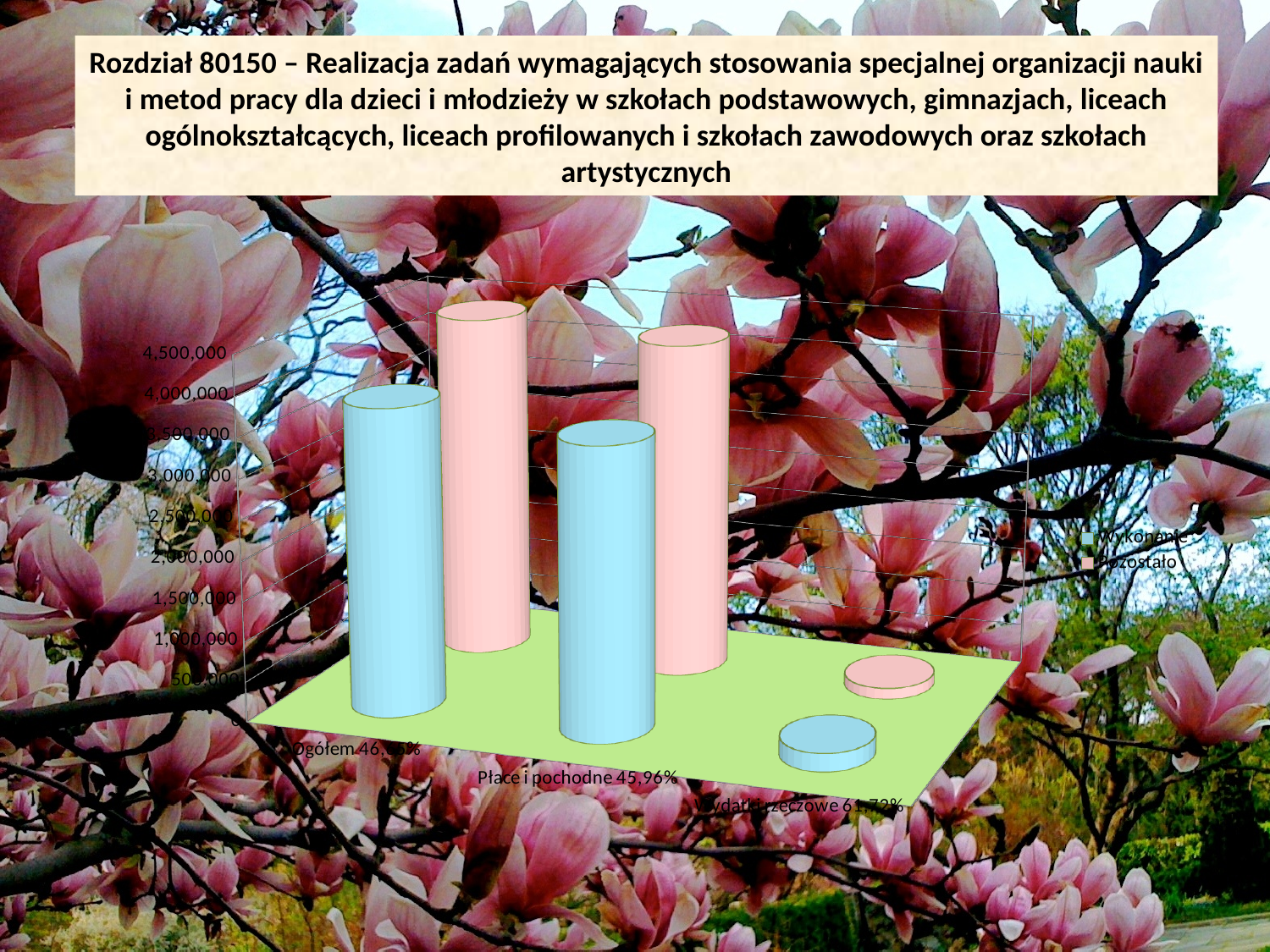
Which is larger, the Wykonanie value for Płace i pochodne or the Wykonanie value for Wydatki rzeczowe? Płace i pochodne What are the two series named in the legend? Wykonanie, Pozostało Which category has the highest Pozostało value? Ogółem Is the Wykonanie value for Ogółem greater or less than 2,000,000? greater What percentage is shown in the category label for Wydatki rzeczowe? 61,72% Is the Wykonanie value for Wydatki rzeczowe greater or less than 500,000? less How many categories are shown on the x axis of the chart? 3 What kind of chart is shown on the slide? bar chart How many series does the legend list? 2 What percentage is shown in the category label for Płace i pochodne? 45,96% Is the Pozostało value for Płace i pochodne greater or less than 1,000,000? greater Which category has the lowest Wykonanie value? Wydatki rzeczowe